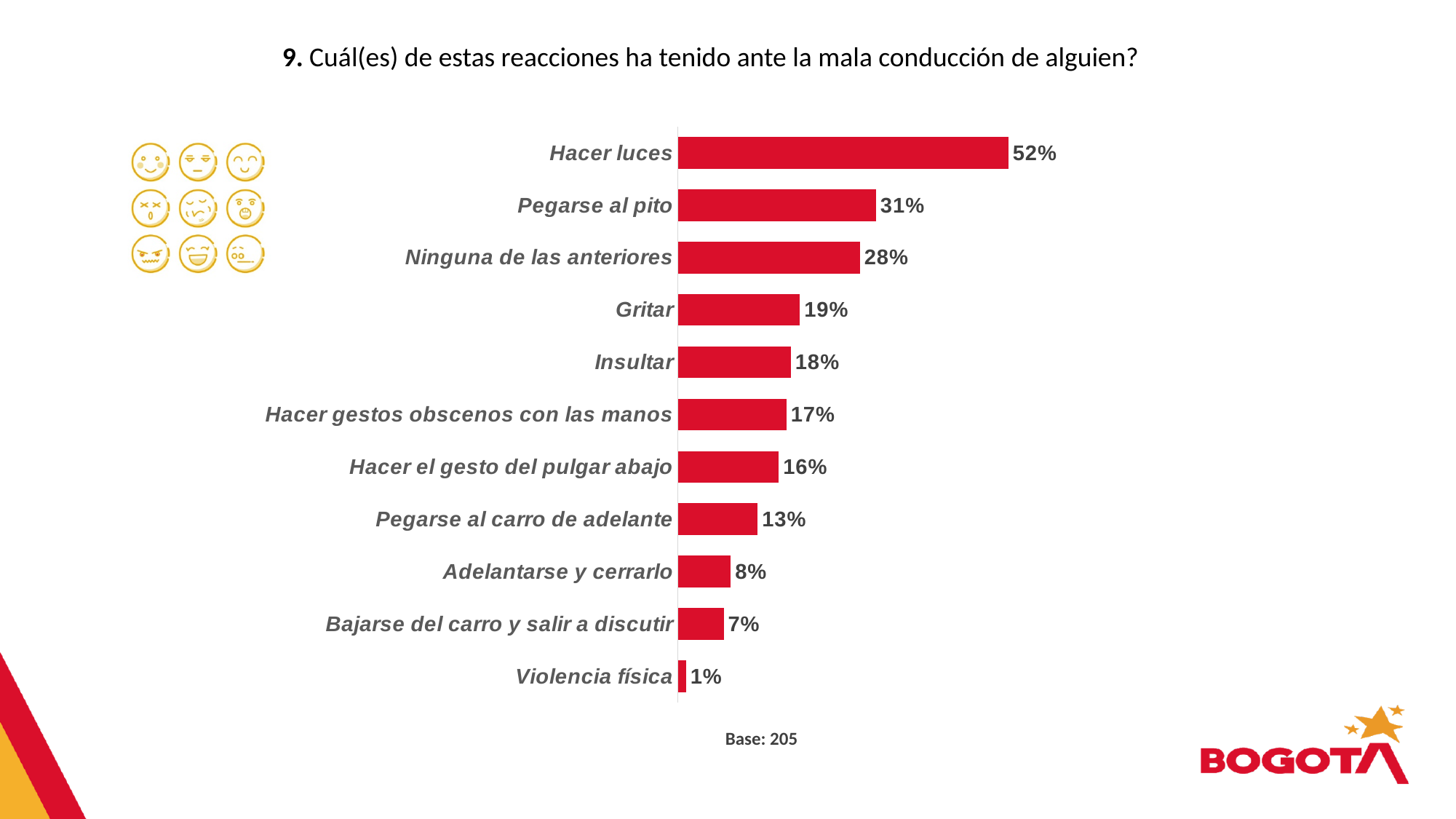
What is the value shown for 'Pegarse al pito'? 31% What base (number of respondents) is stated below the chart? Base: 205 Which reaction has the lowest percentage? Violencia física What is the difference in percentage points between 'Adelantarse y cerrarlo' and 'Bajarse del carro y salir a discutir'? 1 What is the difference in percentage points between 'Hacer luces' and 'Pegarse al pito'? 21 What kind of chart is shown on the slide? Bar chart Which is larger, the value for 'Gritar' or the value for 'Insultar'? Gritar What is the value shown for 'Ninguna de las anteriores'? 28% What percentage is shown for 'Violencia física'? 1% Which reaction has the highest percentage? Hacer luces How many categories (reactions) are shown in the chart? 11 What percentage of respondents reported 'Hacer luces' as a reaction? 52%